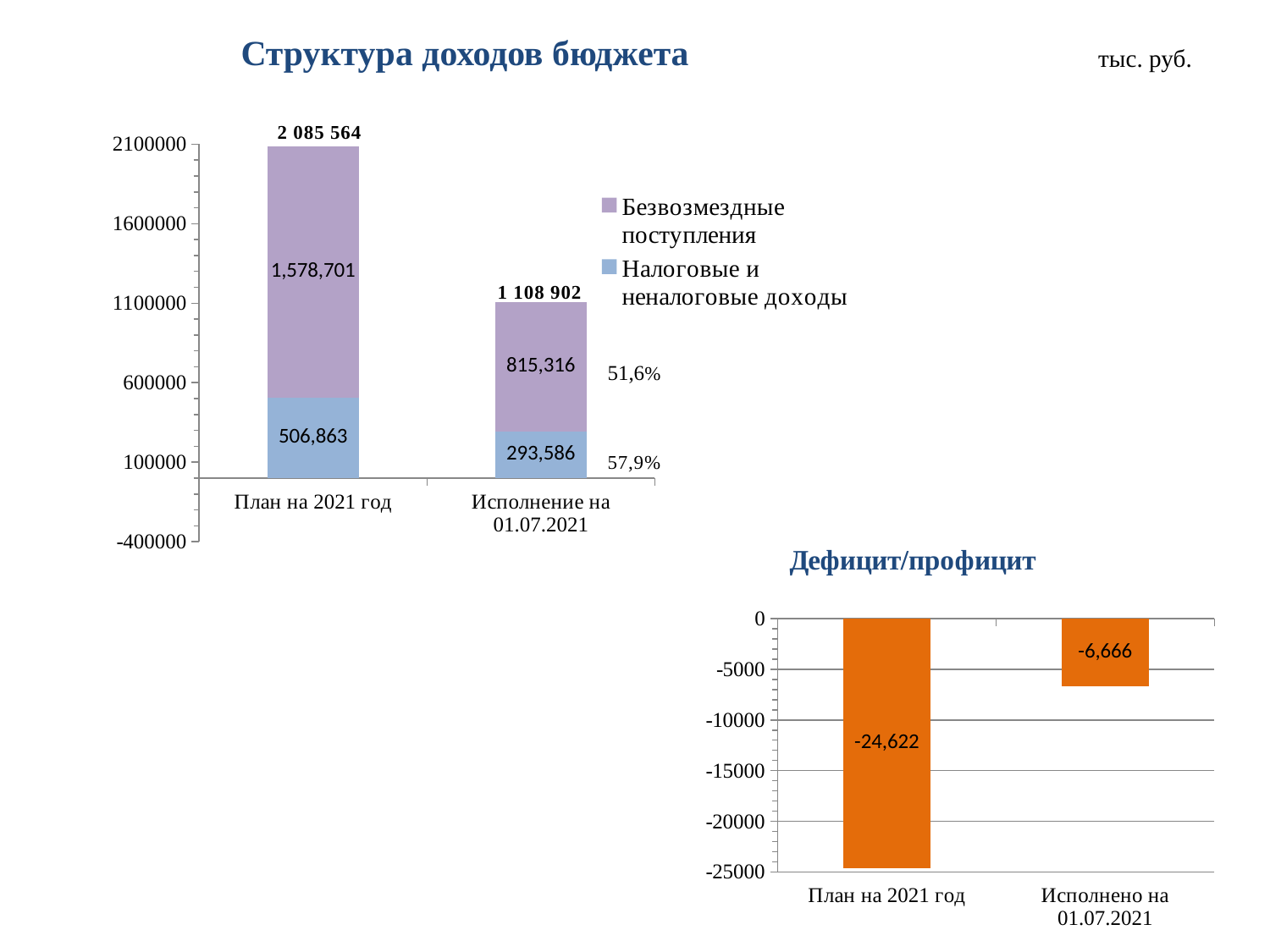
What kind of chart is 'Дефицит/профицит'? Bar chart In the chart 'Структура доходов бюджета', which category has the larger value for 'Налоговые и неналоговые доходы'? План на 2021 год In the chart 'Структура доходов бюджета', what is the total shown above the 'Исполнение на 01.07.2021' bar? 1 108 902 In the chart 'Структура доходов бюджета', what is the value of 'Налоговые и неналоговые доходы' for 'Исполнение на 01.07.2021'? 293,586 In the chart 'Структура доходов бюджета', what is the total shown above the 'План на 2021 год' bar? 2 085 564 In the chart 'Структура доходов бюджета', how many series does the legend list? 2 In the chart 'Дефицит/профицит', what is the value for 'Исполнено на 01.07.2021'? -6,666 In the chart 'Дефицит/профицит', which category has the lowest value? План на 2021 год In the chart 'Структура доходов бюджета', what percentage is shown next to the 'Налоговые и неналоговые доходы' segment of the 'Исполнение на 01.07.2021' bar? 57,9% In the chart 'Дефицит/профицит', what is the value for 'План на 2021 год'? -24,622 In the chart 'Структура доходов бюджета', what is the value of 'Безвозмездные поступления' for 'План на 2021 год'? 1,578,701 In the chart 'Структура доходов бюджета', what is the difference between 'Безвозмездные поступления' for 'План на 2021 год' and for 'Исполнение на 01.07.2021'? 763,385